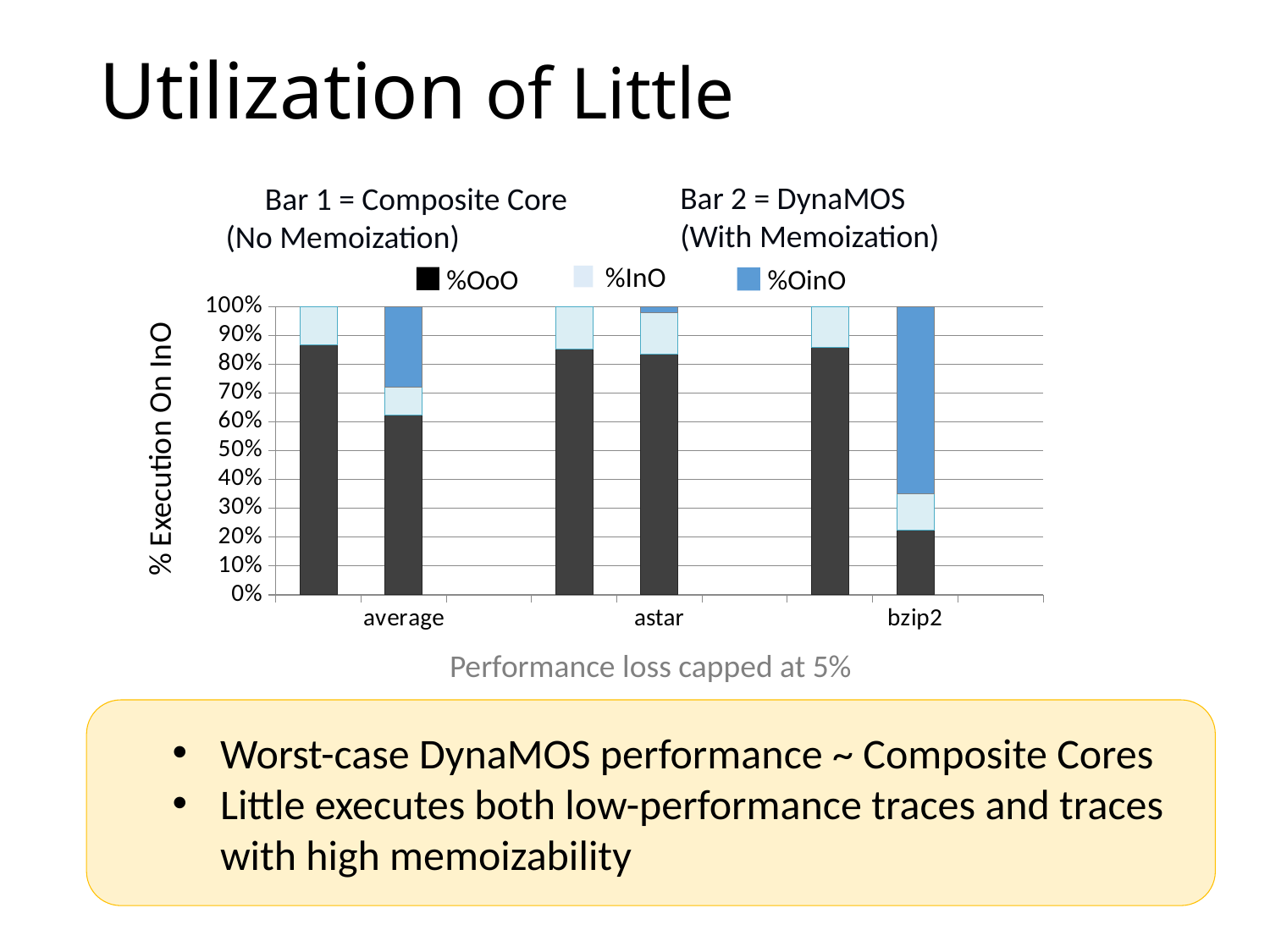
What are the three series listed in the chart legend? %OoO, %InO, %OinO What kind of chart is shown on the slide? Stacked bar chart How many series does the chart legend list? 3 How many categories are shown on the x axis of the chart? 3 Is the %OoO value for the DynaMOS (Bar 2) bar of average greater or less than 70%? less What is the label on the y axis of the chart? % Execution On InO Is the %OoO value for the DynaMOS (Bar 2) bar of bzip2 greater or less than 30%? less Is the %OoO value for the Composite Core (Bar 1) bar of bzip2 greater or less than 80%? greater Which category has the largest %OinO segment in its DynaMOS (Bar 2) bar? bzip2 In the DynaMOS (Bar 2) bars, is the %OoO value larger for average or for bzip2? average Which category has the lowest %OoO value in its DynaMOS (Bar 2) bar? bzip2